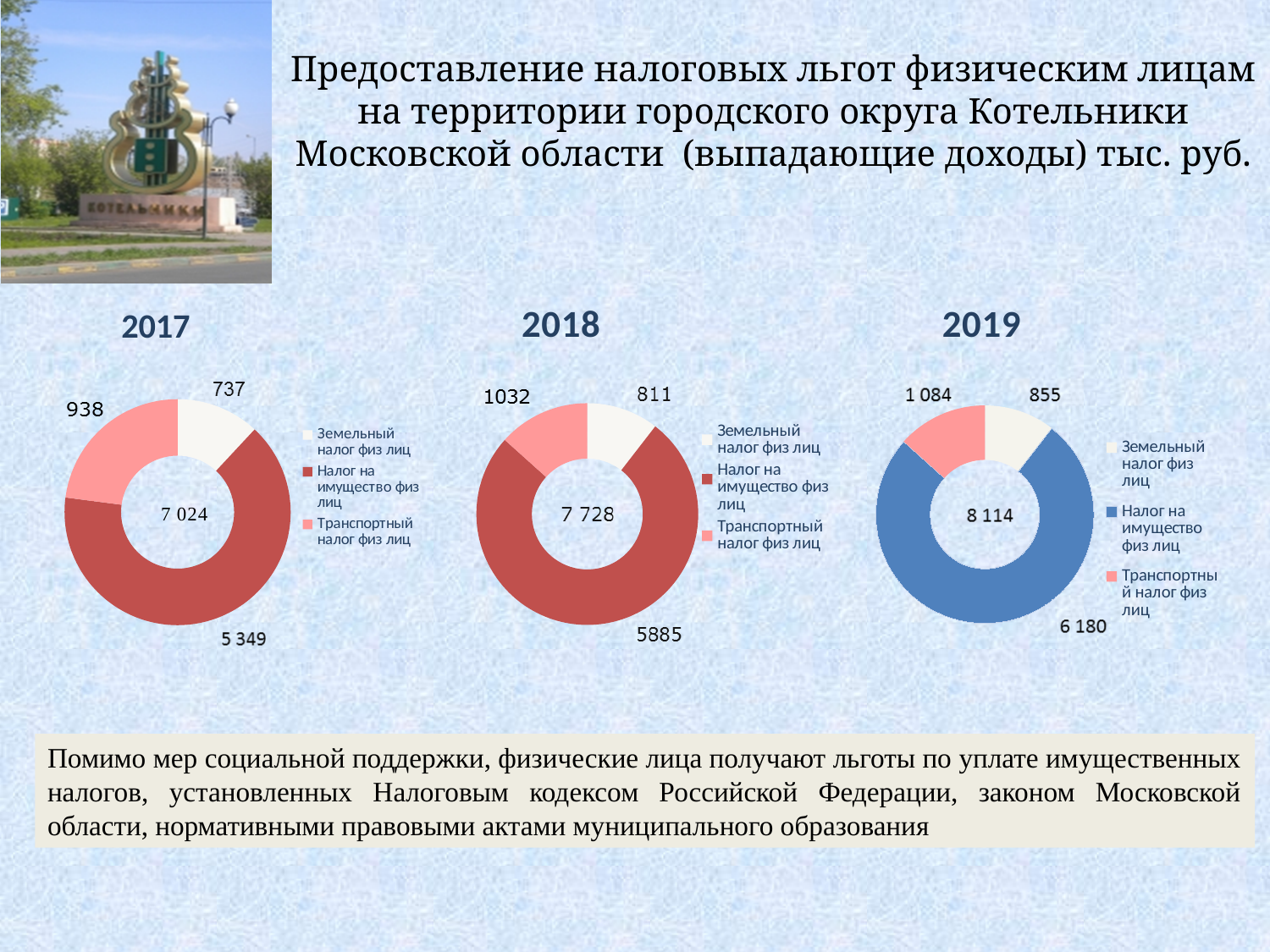
How many entries does the legend of the 2017 chart list? 3 What is the total shown in the centre of the 2017 chart? 7 024 In the 2017 chart, which category has the smallest value? Земельный налог физ лиц In the 2018 chart, what is the value for Транспортный налог физ лиц? 1032 What kind of chart is the 2018 chart? doughnut (ring) chart In the 2017 chart, what is the value for Налог на имущество физ лиц? 5 349 In the 2018 chart, what is the difference between Налог на имущество физ лиц and Транспортный налог физ лиц? 4853 In the 2019 chart, what is the value for Земельный налог физ лиц? 855 In the 2019 chart, which category has the largest value? Налог на имущество физ лиц How many slices does the 2018 chart have? 3 In the 2019 chart, what is the difference between Налог на имущество физ лиц and Земельный налог физ лиц? 5 325 In the 2019 chart, which is larger: Транспортный налог физ лиц or Земельный налог физ лиц? Транспортный налог физ лиц